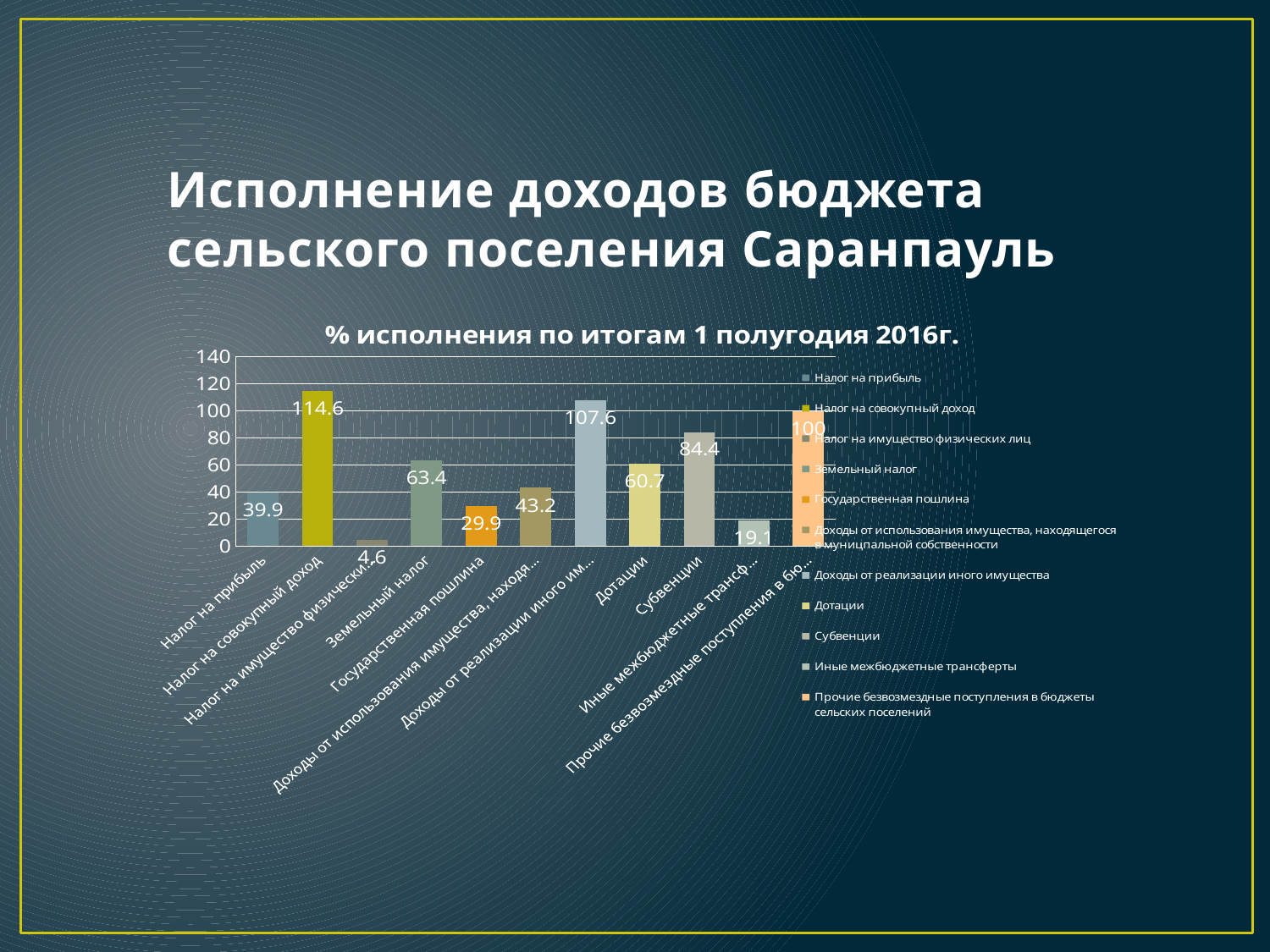
What is the difference between the values for Налог на совокупный доход and Налог на прибыль? 74.7 What is the value for Налог на совокупный доход? 114.6 What is the value for Дотации? 60.7 What is the title of the chart? % исполнения по итогам 1 полугодия 2016г. Is the value for Государственная пошлина greater or less than 40? less Which category has the highest value? Налог на совокупный доход Which is larger, the value for Субвенции or the value for Дотации? Субвенции What is the value for Земельный налог? 63.4 How many bars are plotted in the chart? 11 What kind of chart is shown on the slide? bar chart What is the value for Субвенции? 84.4 Which category has the lowest value? Налог на имущество физических лиц